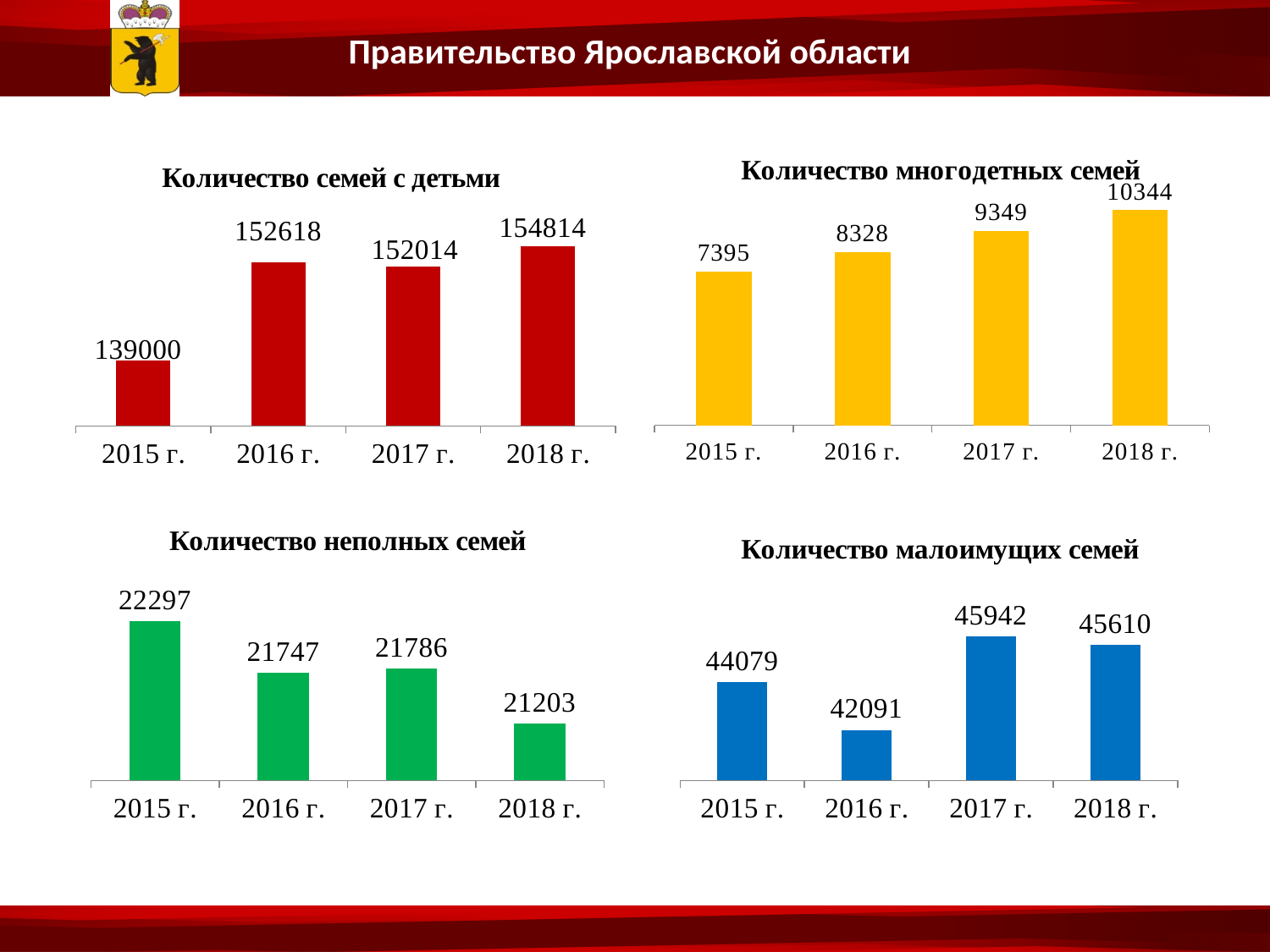
What type of chart is the chart titled "Количество семей с детьми"? bar chart In the chart titled "Количество неполных семей", which year has the lowest value? 2018 г. In the chart titled "Количество многодетных семей", do the values rise or fall from 2015 г. to 2018 г.? rise In the chart titled "Количество семей с детьми", what is the value for 2015 г.? 139000 How many years are shown on the x axis of the chart titled "Количество неполных семей"? 4 In the chart titled "Количество малоимущих семей", which is larger, the value for 2015 г. or the value for 2016 г.? 2015 г. In the chart titled "Количество семей с детьми", which year has the highest value? 2018 г. In the chart titled "Количество малоимущих семей", what is the difference between the values for 2017 г. and 2016 г.? 3851 In the chart titled "Количество многодетных семей", what is the difference between the values for 2018 г. and 2015 г.? 2949 In the chart titled "Количество многодетных семей", what is the value for 2017 г.? 9349 In the chart titled "Количество неполных семей", what is the value for 2016 г.? 21747 In the chart titled "Количество малоимущих семей", what is the value for 2017 г.? 45942